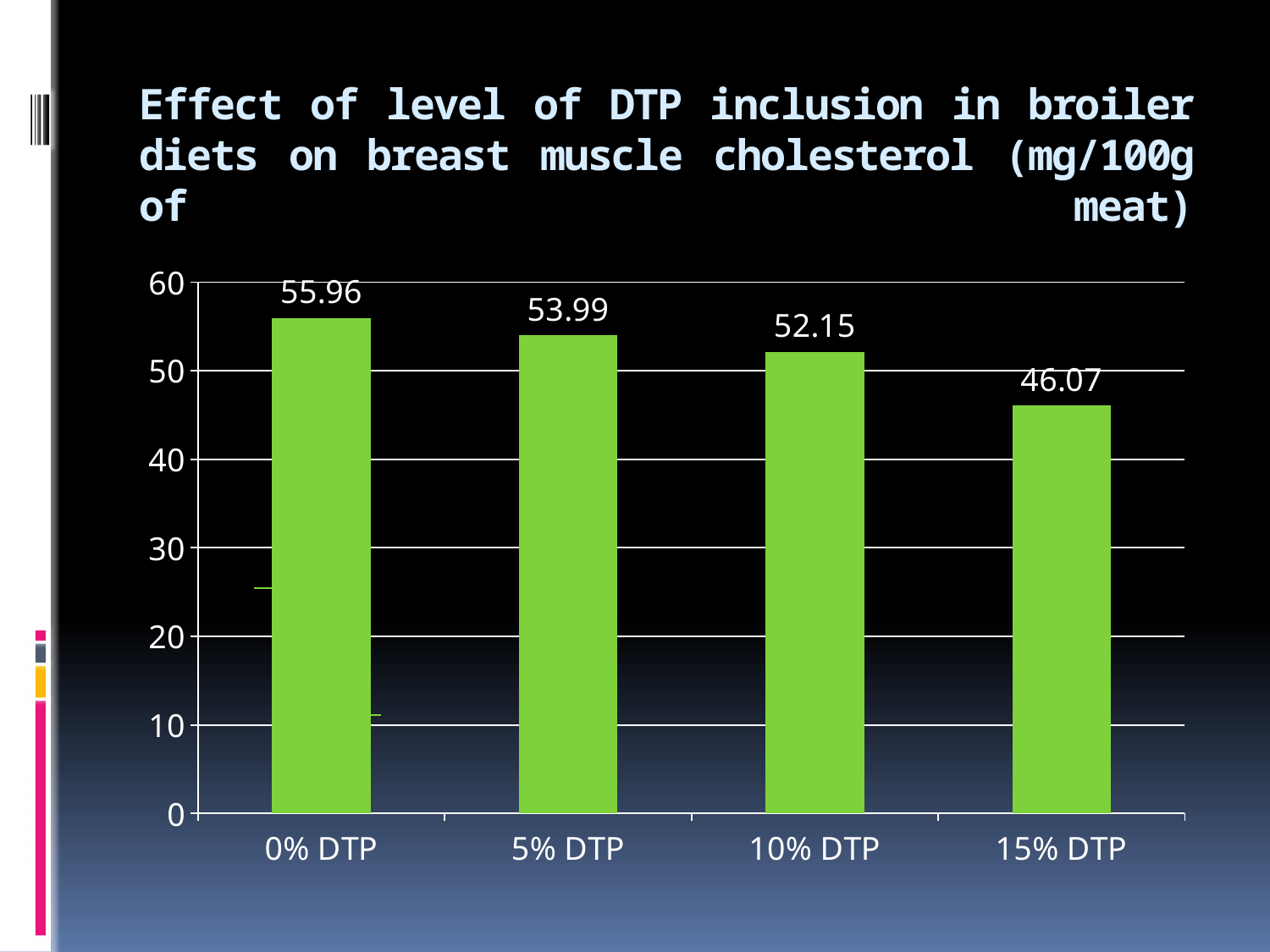
What kind of chart is shown on the slide? bar chart Do the cholesterol values rise or fall as the DTP inclusion level increases? fall What is the difference in cholesterol between 0% DTP and 15% DTP? 9.89 Is the value for 15% DTP greater or less than 50? less What is the breast muscle cholesterol value for 10% DTP? 52.15 Which DTP inclusion level has the lowest breast muscle cholesterol? 15% DTP What is the breast muscle cholesterol value for 0% DTP? 55.96 Which has a higher cholesterol value, 5% DTP or 10% DTP? 5% DTP Which DTP inclusion level has the highest breast muscle cholesterol? 0% DTP What is the breast muscle cholesterol value for 15% DTP? 46.07 What is the breast muscle cholesterol value for 5% DTP? 53.99 How many DTP inclusion levels are shown on the chart? 4